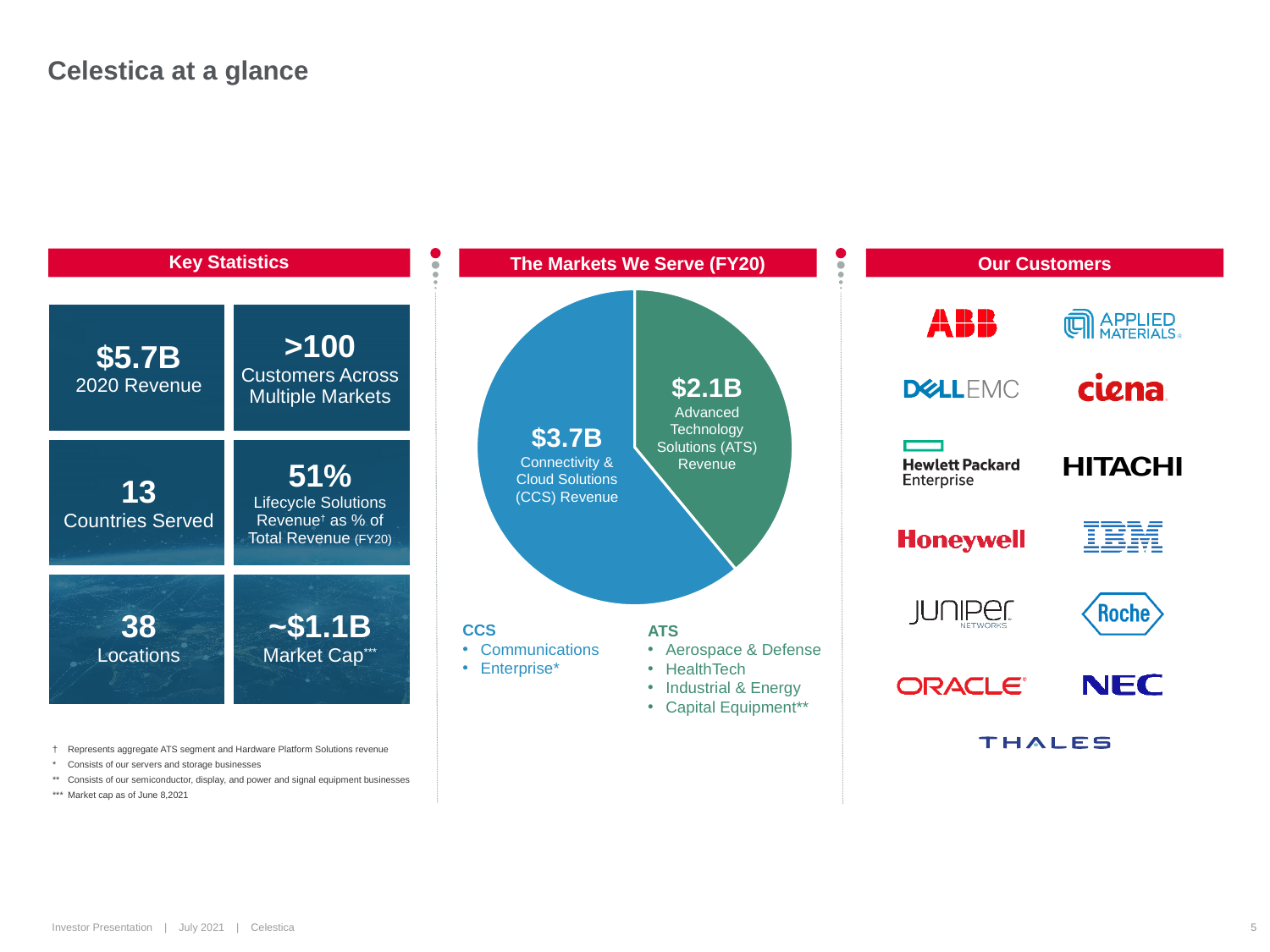
What is the value of the Advanced Technology Solutions (ATS) Revenue slice in the pie chart? $2.1B What is the difference between CCS Revenue and ATS Revenue in the pie chart? $1.6B How many slices does the pie chart have? 2 What is the value of the Connectivity & Cloud Solutions (CCS) Revenue slice in the pie chart? $3.7B What colour is the ATS Revenue slice in the pie chart? Green What kind of chart is shown under 'The Markets We Serve (FY20)'? Pie chart What is the title of the section containing the pie chart? The Markets We Serve (FY20) Which segment has the largest slice in the pie chart? Connectivity & Cloud Solutions (CCS) Revenue Which segment has the smallest slice in the pie chart? Advanced Technology Solutions (ATS) Revenue Which is larger in the pie chart, CCS Revenue or ATS Revenue? CCS Revenue